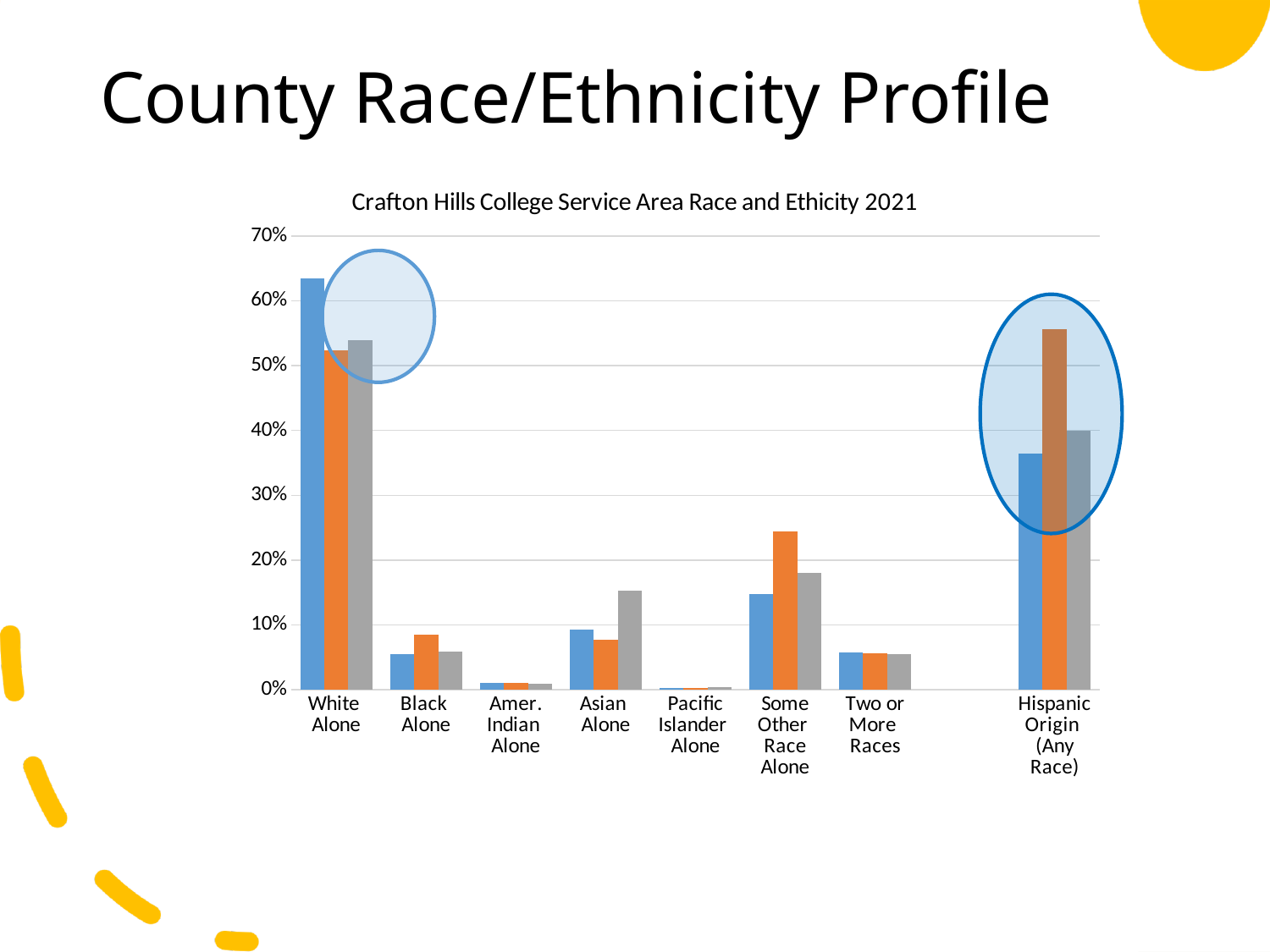
Is the orange bar for Hispanic Origin (Any Race) greater or less than 50%? greater Which category has the tallest bar in the chart? White Alone Is the blue bar for Hispanic Origin (Any Race) greater or less than 40%? less How many race/ethnicity categories are shown on the x axis? 8 Which category has the lowest bars in the chart? Pacific Islander Alone Is the orange bar for Some Other Race Alone greater or less than 20%? greater How many bars are plotted for each category? 3 What is the title of the chart? Crafton Hills College Service Area Race and Ethicity 2021 Which two categories are highlighted with circles on the chart? White Alone and Hispanic Origin (Any Race) Which is larger: the orange bar for Some Other Race Alone or the gray bar for Asian Alone? The orange bar for Some Other Race Alone What kind of chart is shown on the slide? Bar chart